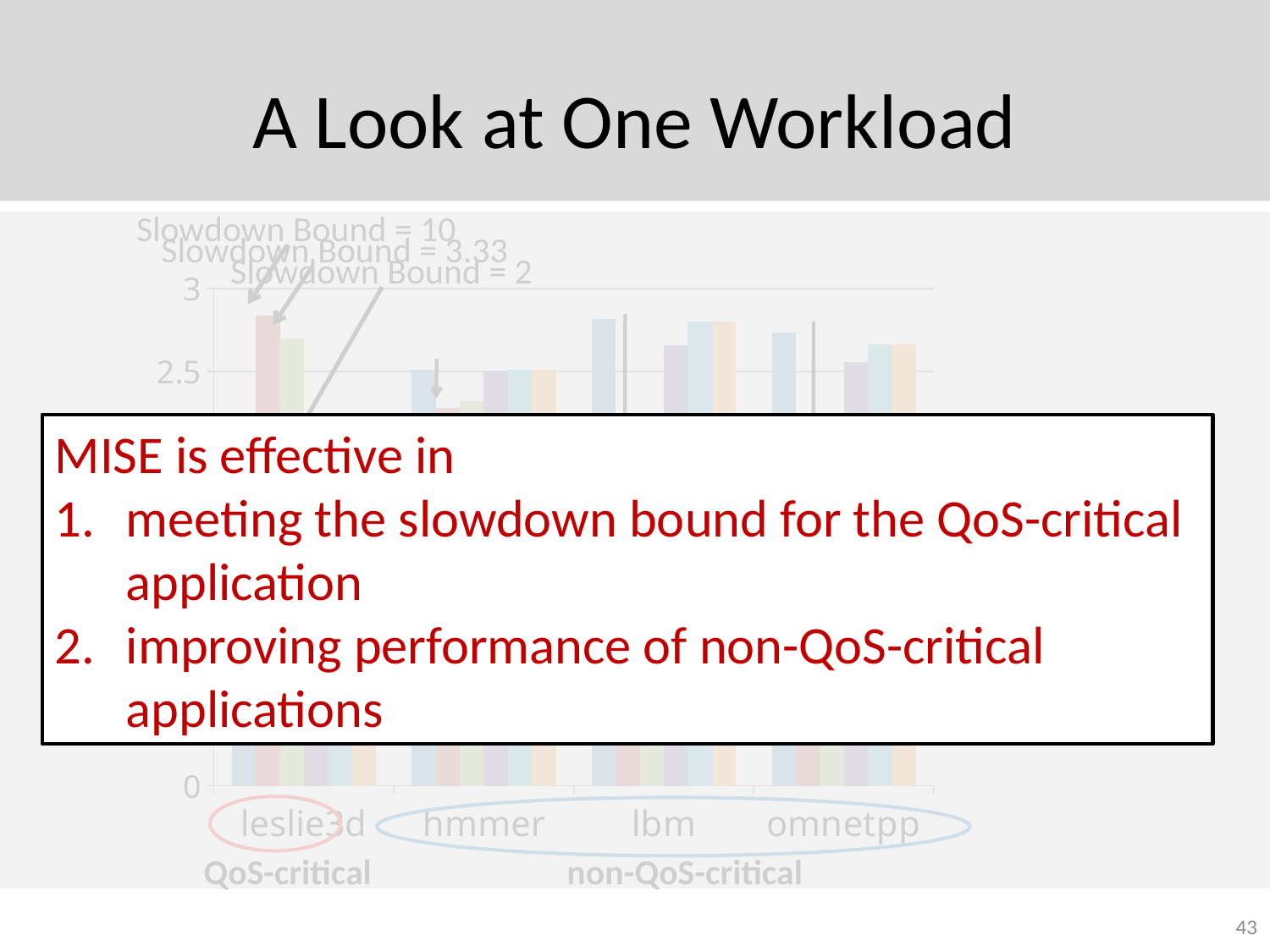
What kind of chart is shown on the slide? bar chart Which categories on the x axis are grouped as non-QoS-critical? hmmer, lbm, omnetpp Is the tallest bar for lbm greater or less than 2.5? greater Is the tallest bar for leslie3d greater or less than 2.5? greater Is the tallest bar for leslie3d greater or less than 3? less What is the highest tick value shown on the y axis of the chart? 3 Which category on the x axis is labeled as QoS-critical? leslie3d How many categories are shown on the x axis of the chart? 4